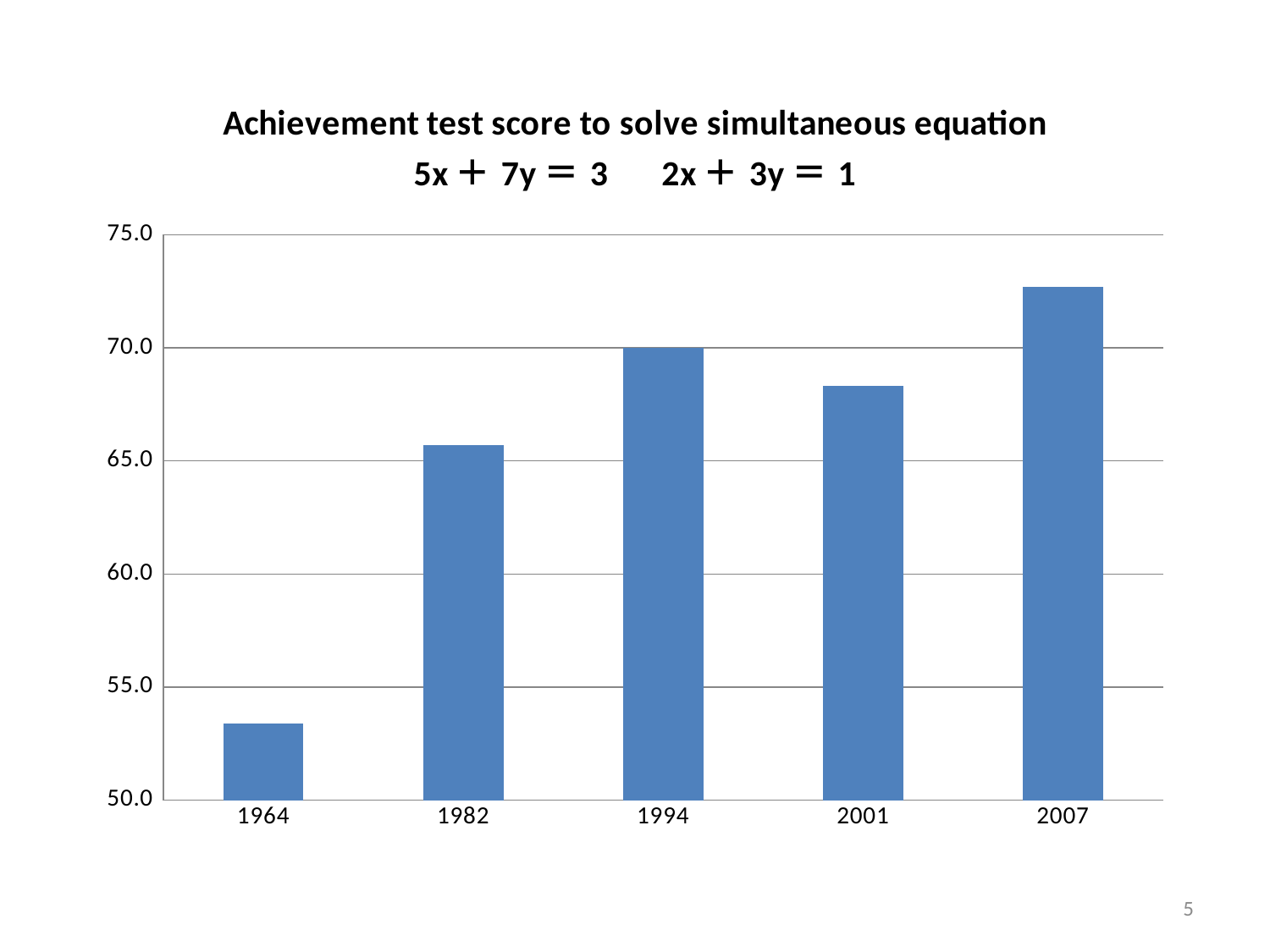
How many years are shown on the x axis of the chart? 5 Is the value for 2007 greater or less than 70.0? greater Is the value for 2001 greater or less than 70.0? less Does the value rise or fall from 1964 to 1982? rise Which year has the larger value, 1994 or 2001? 1994 What kind of chart is shown on the slide? bar chart Which year has the highest achievement test score? 2007 What is the title of the chart? Achievement test score to solve simultaneous equation 5x＋7y＝3 2x＋3y＝1 Which year has the larger value, 1982 or 2001? 2001 Which year has the lowest achievement test score? 1964 Is the value for 1982 greater or less than 65.0? greater